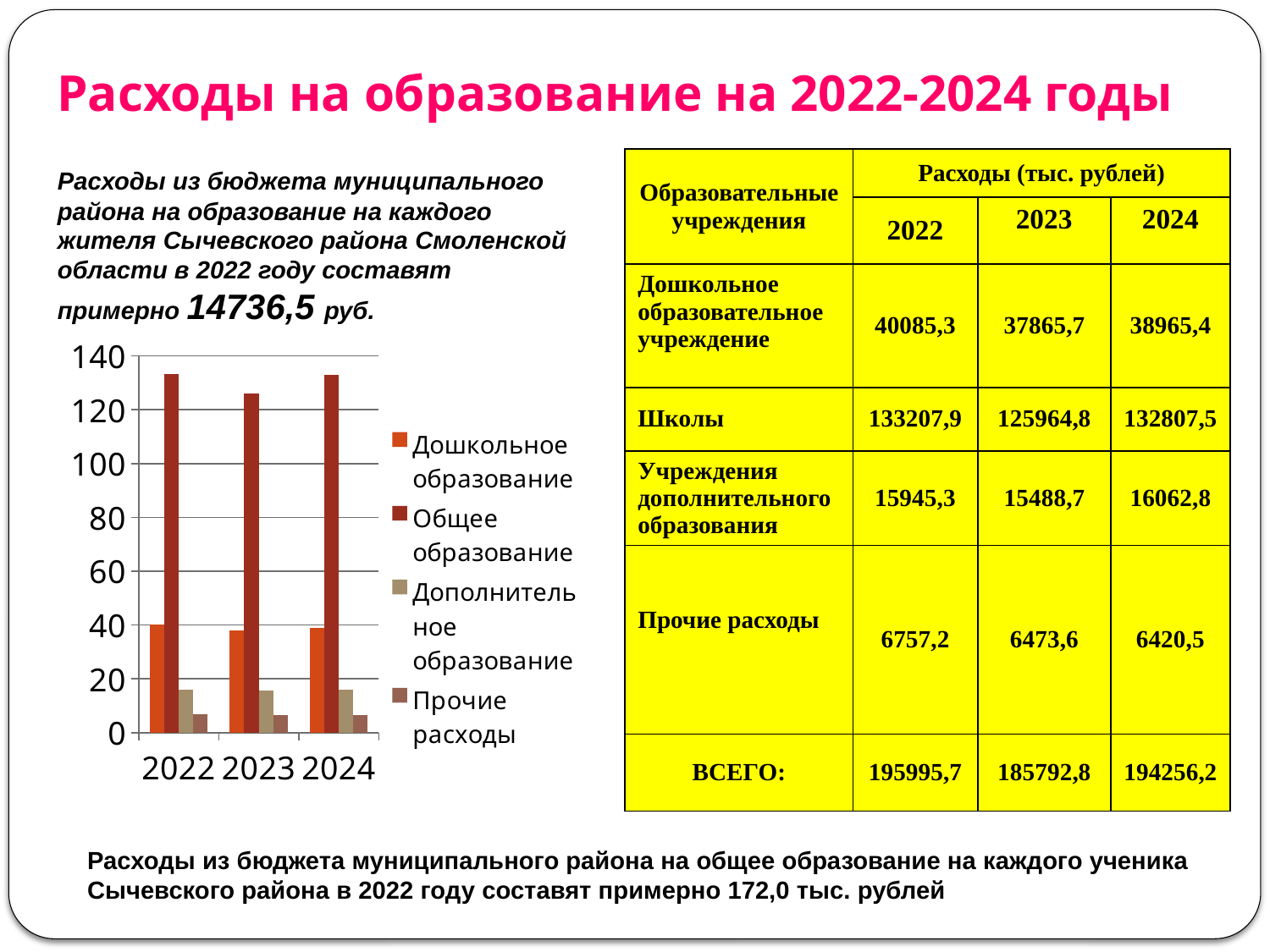
Is the value for Дошкольное образование in 2023 greater or less than 60? less How many series does the chart legend list? 4 Which is larger in 2023: Дошкольное образование or Дополнительное образование? Дошкольное образование Is the value for Дополнительное образование in 2024 greater or less than 20? less Is the value for Общее образование in 2022 greater or less than 120? greater What kind of chart is shown on the slide? bar chart Which is larger: Общее образование in 2022 or Общее образование in 2023? 2022 How many years are shown on the x axis of the chart? 3 Which series has the tallest bar in 2022? Общее образование Which series has the shortest bar in 2024? Прочие расходы What is the highest value shown on the chart's vertical axis? 140